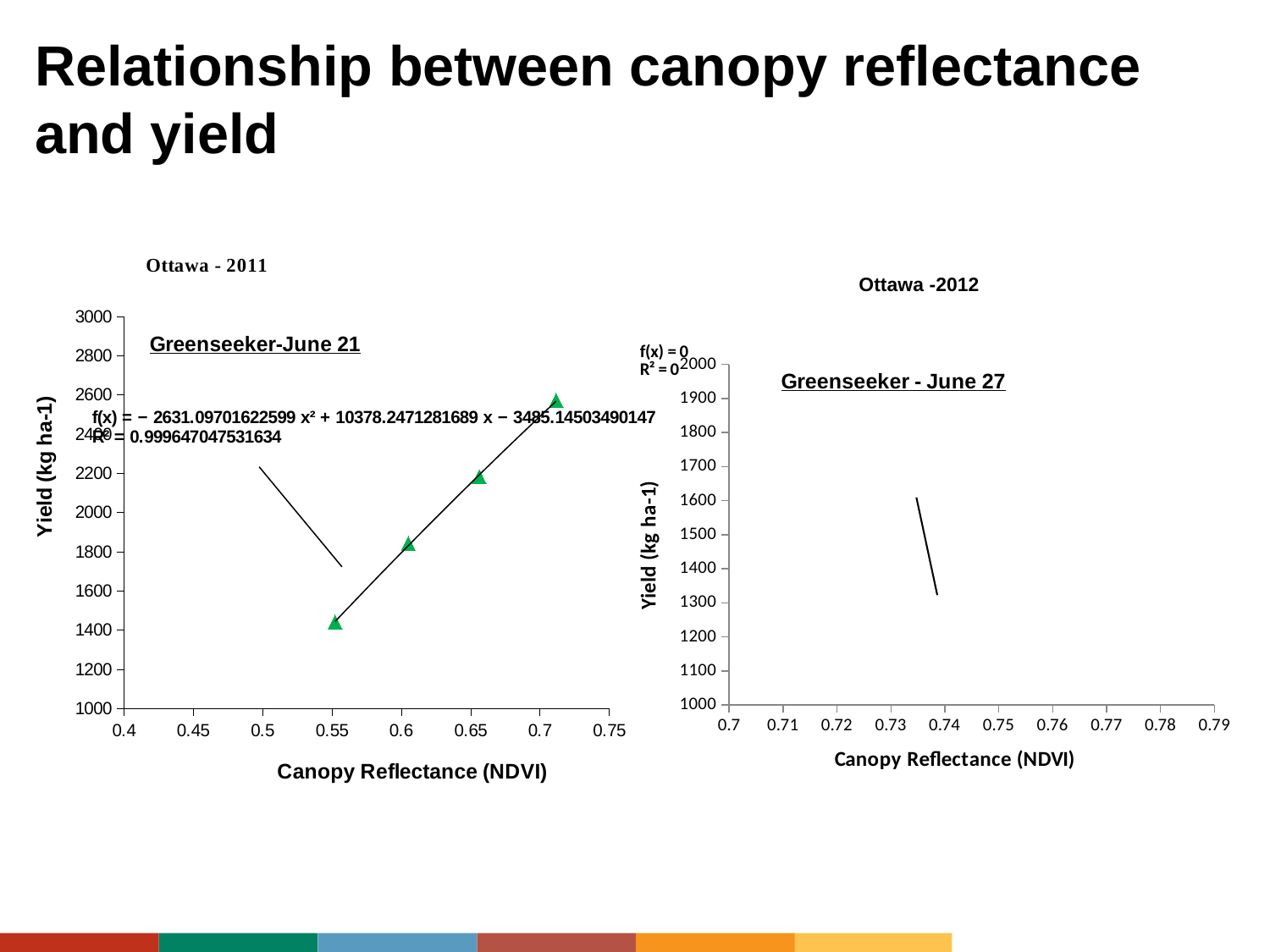
What kind of chart is the Ottawa - 2011 chart on the left? Scatter chart What is the minimum value shown on the x-axis of the Ottawa - 2011 chart? 0.4 What R² value is printed on the Ottawa - 2011 chart for the fitted curve? 0.999647047531634 What is the maximum value shown on the y-axis of the Ottawa -2012 chart? 2000 How many data points are plotted in the Ottawa - 2011 chart? 4 What sensor and date label is shown inside the Ottawa -2012 chart on the right? Greenseeker - June 27 In the Ottawa - 2011 chart, which point has the higher yield: the one with the lowest NDVI or the one with the highest NDVI? The one with the highest NDVI In the Ottawa - 2011 chart, does yield rise or fall as canopy reflectance (NDVI) increases? Rise In the Ottawa - 2011 chart, is the yield of the point with the lowest NDVI greater or less than 1600? less What is the x-axis title of the Ottawa - 2011 chart? Canopy Reflectance (NDVI) In the Ottawa - 2011 chart, is the yield of the point with the highest NDVI greater or less than 2400? greater In the Ottawa - 2011 chart, is the NDVI of the leftmost data point greater or less than 0.5? greater